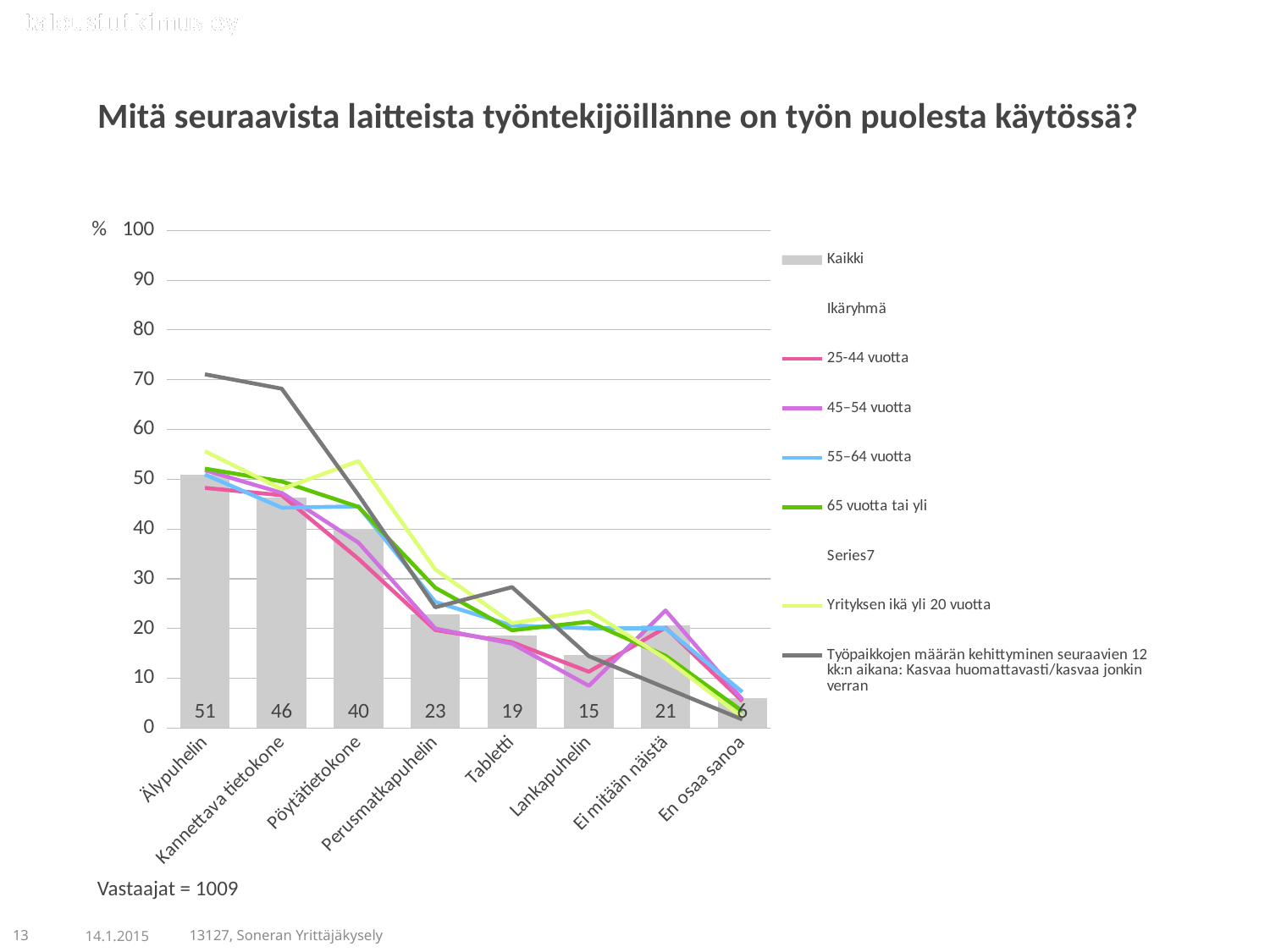
Which category has the highest Kaikki bar? Älypuhelin Is the value of the Työpaikkojen määrän kehittyminen line for Älypuhelin greater or less than 60? greater Which has a larger Kaikki value, Perusmatkapuhelin or Ei mitään näistä? Perusmatkapuhelin What is the value of the Kaikki bar for Lankapuhelin? 15 Is the value of the 45–54 vuotta line for Ei mitään näistä greater or less than 20? greater What is the value of the Kaikki bar for Tabletti? 19 Do the Kaikki bar values rise or fall from Älypuhelin to Tabletti? fall What is the value of the Kaikki bar for Älypuhelin? 51 How many categories are shown on the x axis? 8 What is the difference between the Kaikki values for Älypuhelin and Kannettava tietokone? 5 Which category has the lowest Kaikki bar? En osaa sanoa What kind of chart is this? A bar chart combined with line series